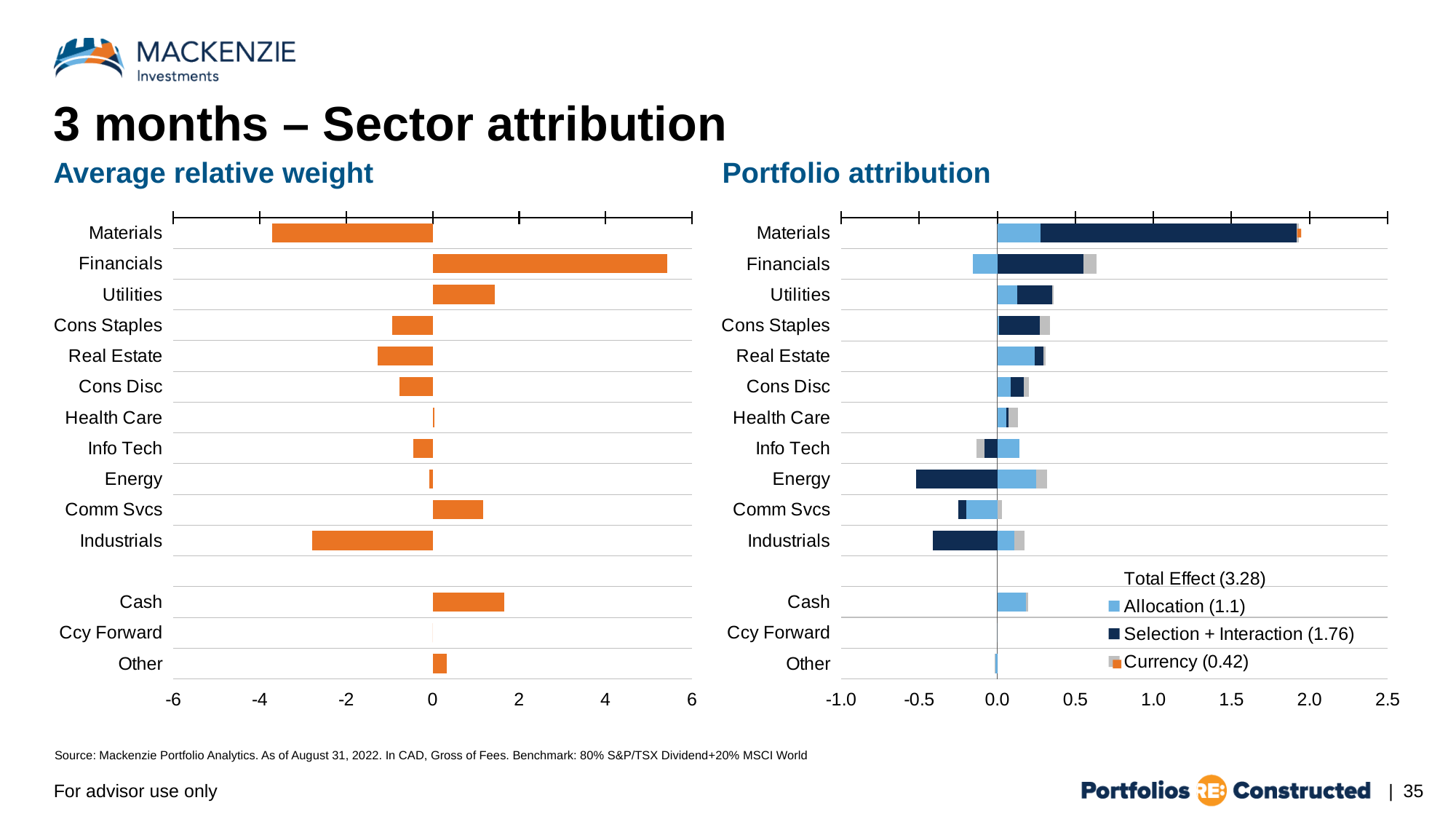
In the 'Portfolio attribution' chart, what is the Total Effect shown on the chart? 3.28 In the 'Average relative weight' chart, which sector has the lowest average relative weight? Materials In the 'Average relative weight' chart, which is larger, the value for Utilities or the value for Comm Svcs? Utilities How many categories are shown on the 'Average relative weight' chart? 14 In the 'Average relative weight' chart, is the value for Industrials greater or less than -2? less What kind of chart is the 'Average relative weight' chart? bar chart In the 'Average relative weight' chart, which sector has the highest average relative weight? Financials In the 'Average relative weight' chart, is the value for Financials greater or less than 4? greater In the 'Portfolio attribution' chart, what is the total Allocation effect shown in the legend? 1.1 How many series does the legend of the 'Portfolio attribution' chart list? 4 In the 'Portfolio attribution' chart, which sector has the largest positive Selection + Interaction effect? Materials In the 'Portfolio attribution' chart, is the Selection + Interaction value for Energy greater or less than 0.0? less